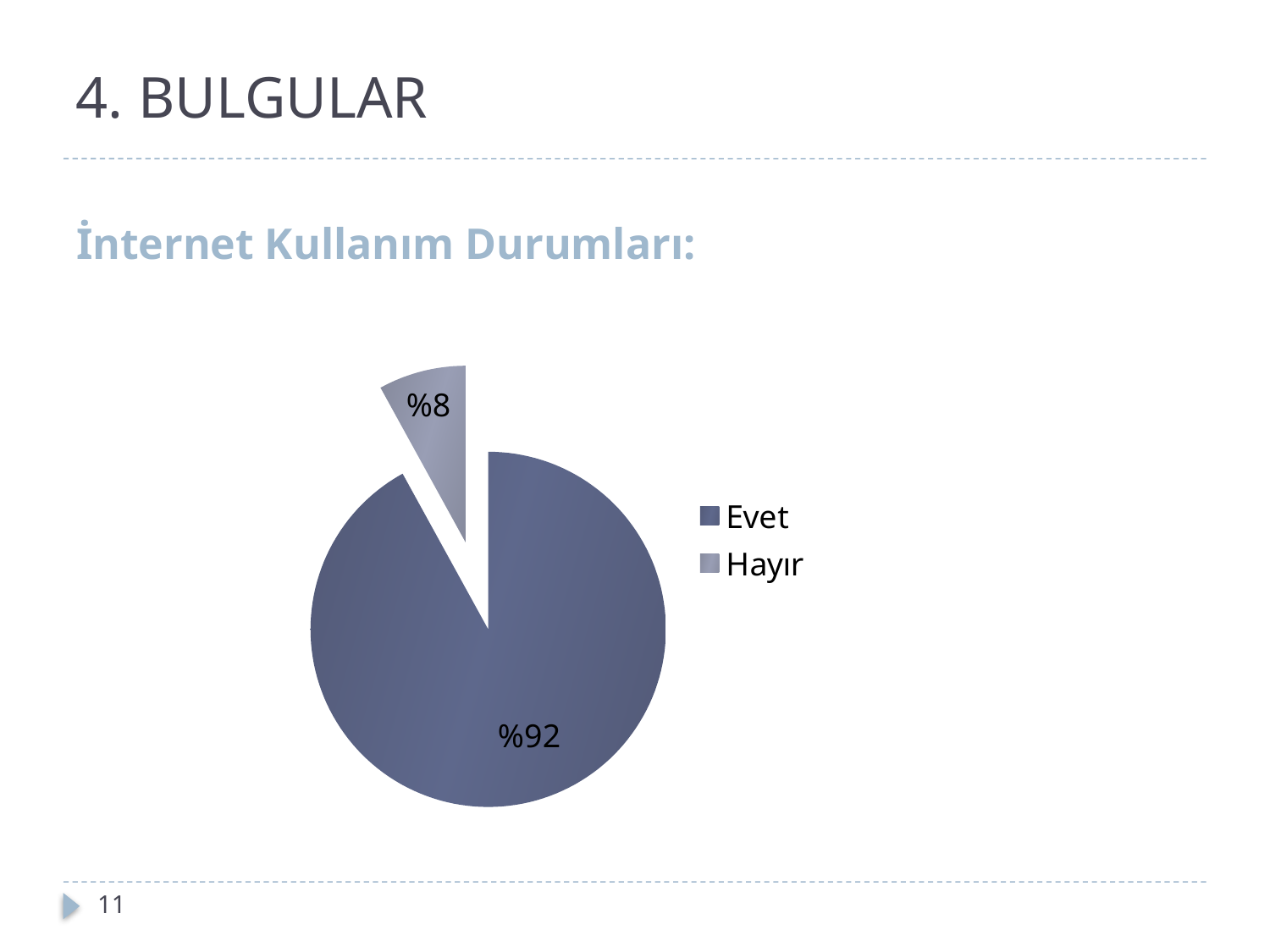
What is the difference between the Evet and Hayır values? %84 How many entries does the legend list? 2 What is the value for Hayır? %8 Which category has the largest slice? Evet What is the value for Evet? %92 What share of the pie does Hayır represent? %8 What is the heading above the chart? İnternet Kullanım Durumları: Which legend entry is shown in the lighter grey colour? Hayır Which category has the smallest slice? Hayır Which is larger, Evet or Hayır? Evet What kind of chart is shown on the slide? pie chart How many slices does the pie chart have? 2